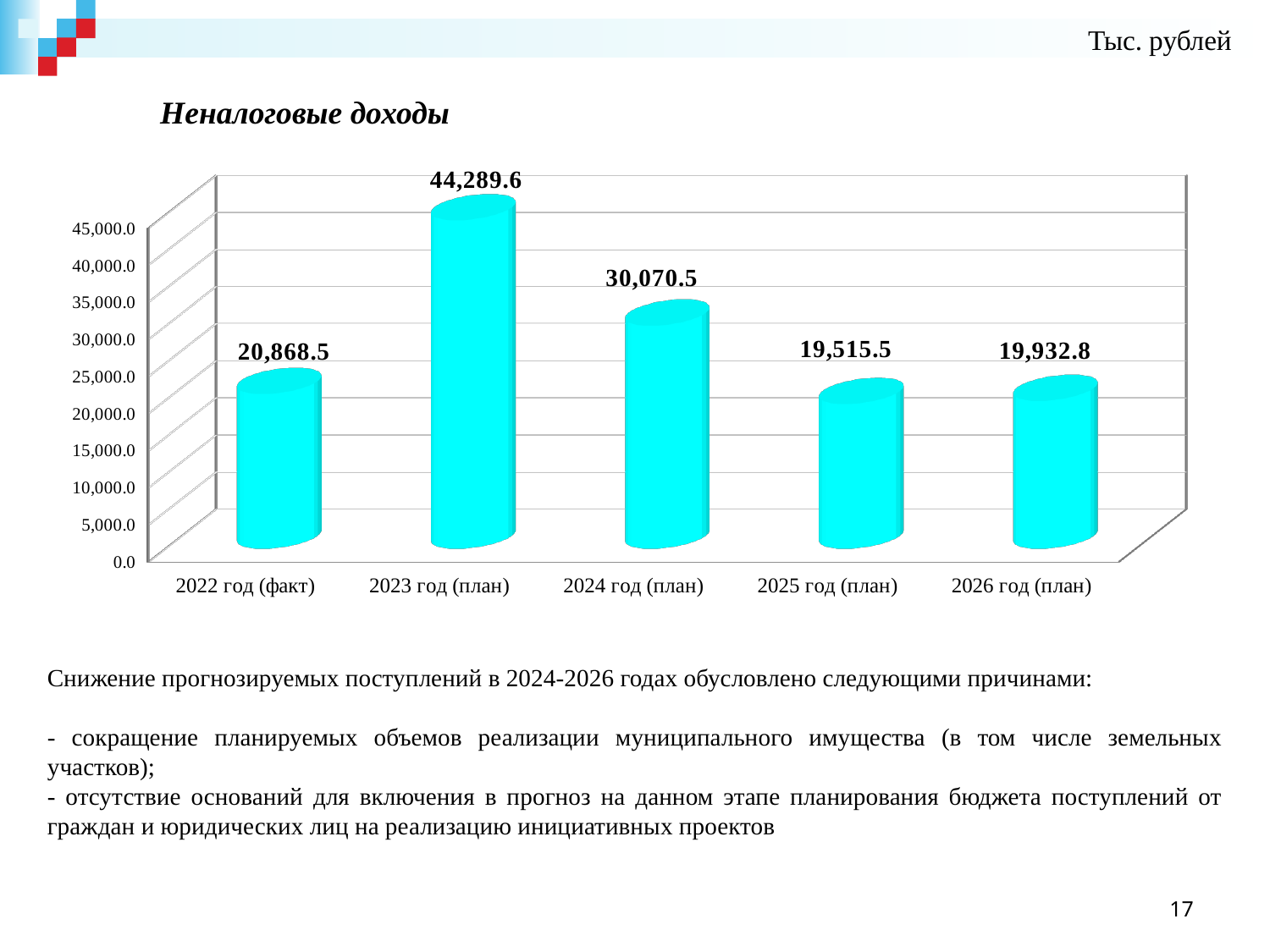
What is the title of the chart? Неналоговые доходы Is the value for 2024 год (план) greater or less than 25,000.0? greater How many categories are shown on the x axis? 5 What is the value for 2026 год (план)? 19,932.8 What is the difference between the values for 2024 год (план) and 2025 год (план)? 10,555.0 What is the value for 2023 год (план)? 44,289.6 Which category has the lowest value? 2025 год (план) Which is larger, the value for 2024 год (план) or the value for 2026 год (план)? 2024 год (план) What is the difference between the values for 2023 год (план) and 2022 год (факт)? 23,421.1 What is the value for 2022 год (факт)? 20,868.5 What kind of chart is shown on the slide? bar chart Which category has the highest value? 2023 год (план)